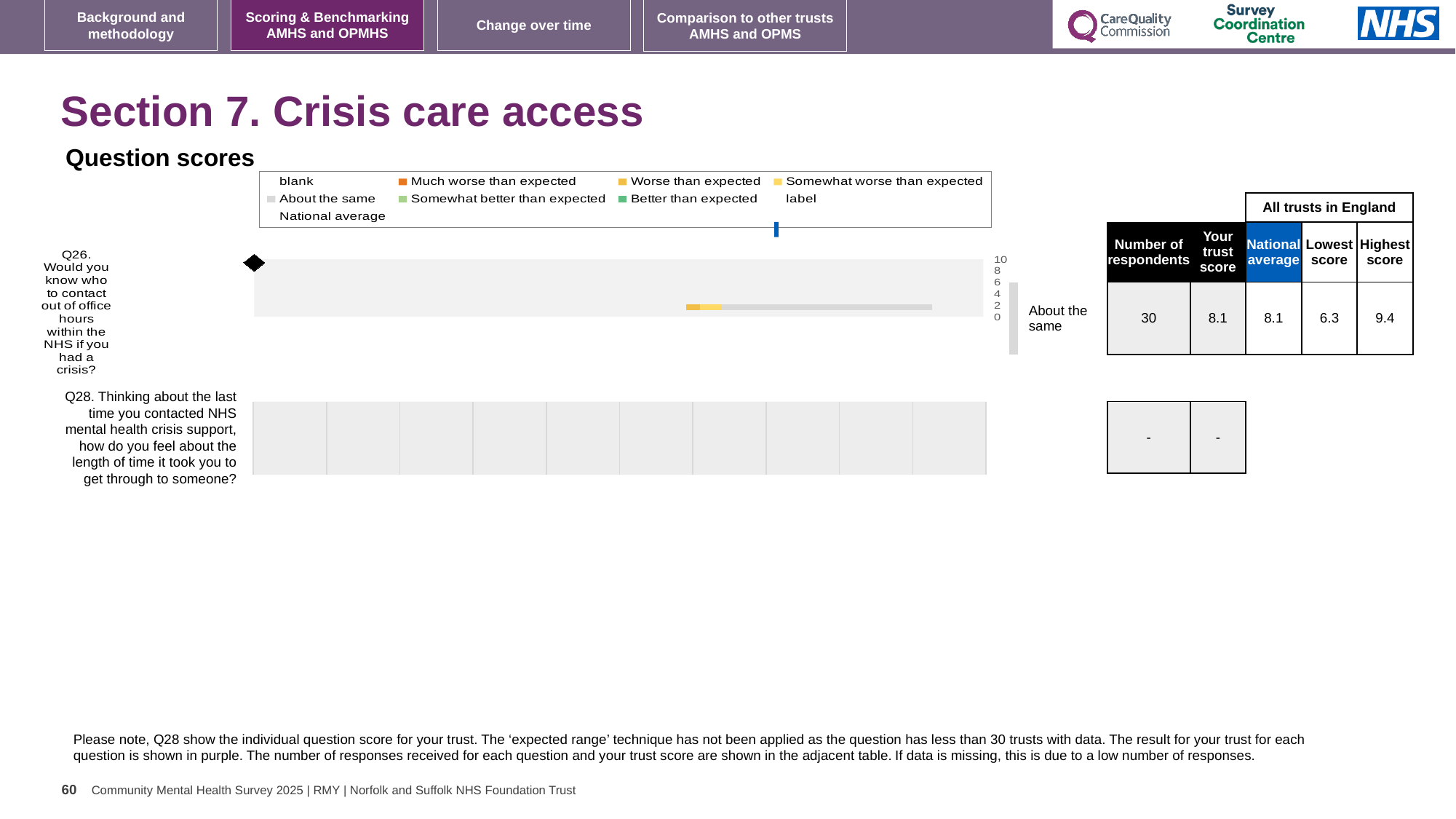
According to the table beside the chart, what is the highest score among all trusts in England for Q26? 9.4 What is the difference between the highest score and the lowest score for Q26 in the table beside the chart? 3.1 According to the table beside the chart, what is your trust score for Q26? 8.1 How many questions (categories) are listed on the chart's vertical axis? 2 Is the trust score for Q26 greater or less than 6? greater What kind of chart is shown under 'Question scores'? bar chart What value is shown for the number of respondents for Q28 in the table beside the chart? - According to the table beside the chart, what is the national average for Q26? 8.1 What benchmark label is shown next to the Q26 bar? About the same According to the table beside the chart, what is the lowest score among all trusts in England for Q26? 6.3 How many entries does the chart legend list? 9 According to the table beside the chart, what is the number of respondents for Q26? 30